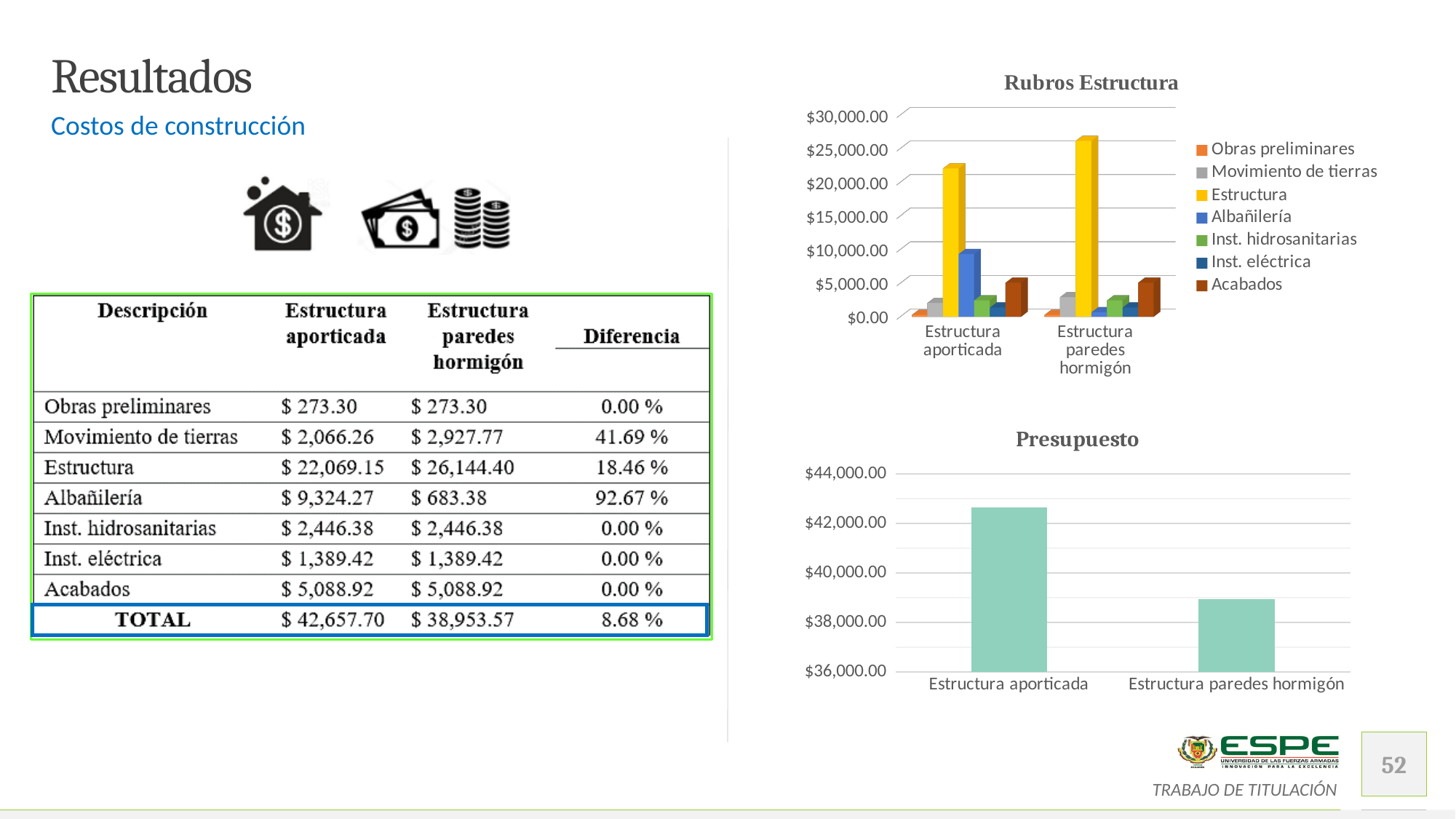
In the "Presupuesto" chart, is the value for Estructura paredes hormigón greater or less than $40,000.00? less What type of chart is the "Presupuesto" chart? bar chart How many series does the legend of the "Rubros Estructura" chart list? 7 In the "Presupuesto" chart, which category has the higher value? Estructura aporticada How many categories are shown on the x axis of the "Presupuesto" chart? 2 In the "Rubros Estructura" chart, is the Estructura value for Estructura paredes hormigón greater or less than $25,000.00? greater In the "Rubros Estructura" chart, which category has the larger Albañilería value, Estructura aporticada or Estructura paredes hormigón? Estructura aporticada In the "Presupuesto" chart, do the values rise or fall from Estructura aporticada to Estructura paredes hormigón? fall What type of chart is the "Rubros Estructura" chart? bar chart In the "Rubros Estructura" chart, which series has the highest value for Estructura aporticada? Estructura In the "Rubros Estructura" chart, which colour represents the Estructura series? yellow